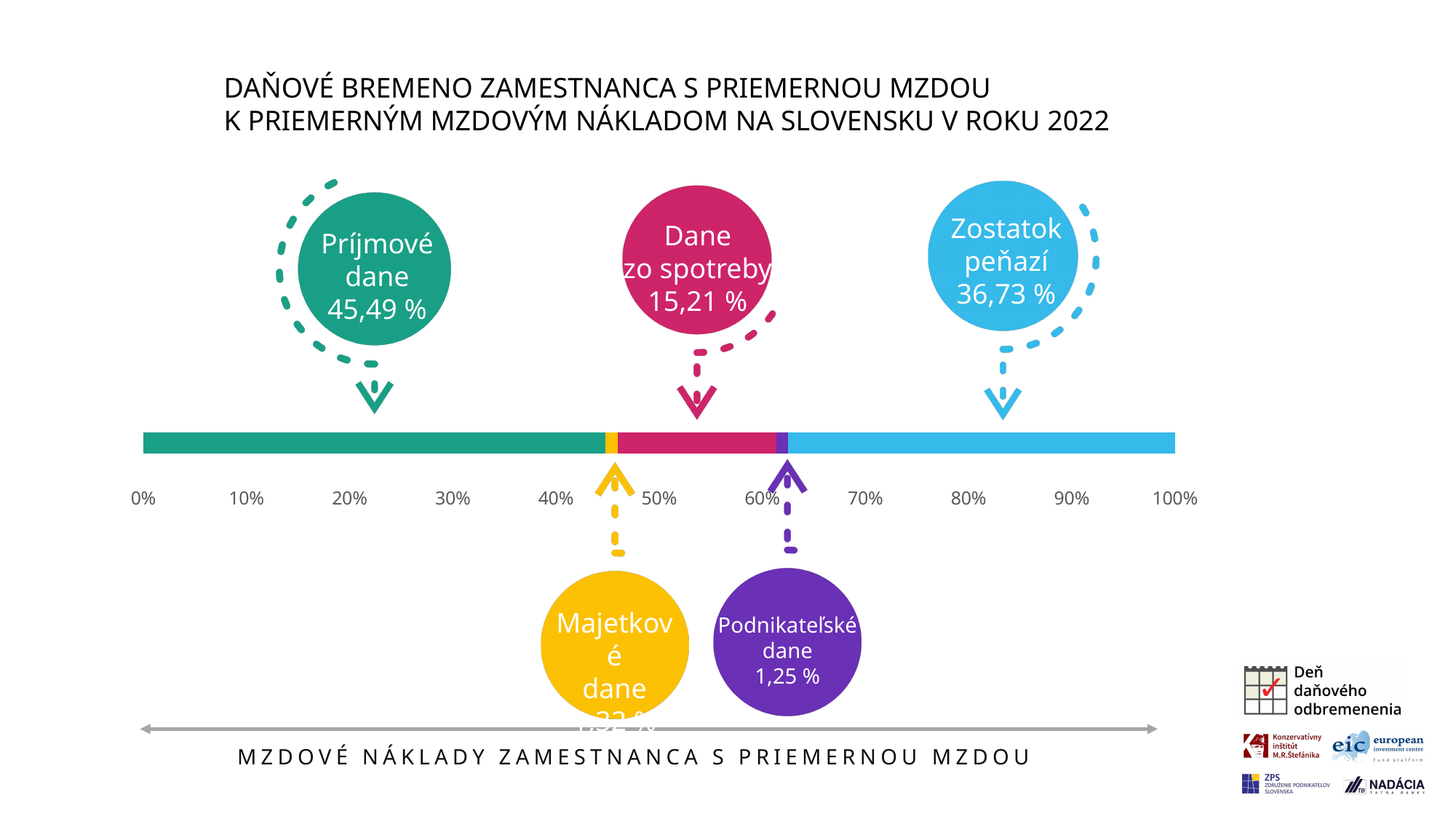
What kind of chart is shown on the slide? Stacked horizontal bar chart Which is larger, Príjmové dane or Zostatok peňazí? Príjmové dane Which is larger, Dane zo spotreby or Podnikateľské dane? Dane zo spotreby How many segments make up the stacked bar? 5 What is the highest value shown on the percentage axis? 100% What is the value shown for Podnikateľské dane? 1,25 % What is the value shown for Zostatok peňazí? 36,73 % What is the value shown for Dane zo spotreby? 15,21 % What is the difference between Príjmové dane and Zostatok peňazí? 8,76 % What is the difference between Zostatok peňazí and Dane zo spotreby? 21,52 % What is the value shown for Príjmové dane? 45,49 % Which category has the largest share of the bar? Príjmové dane